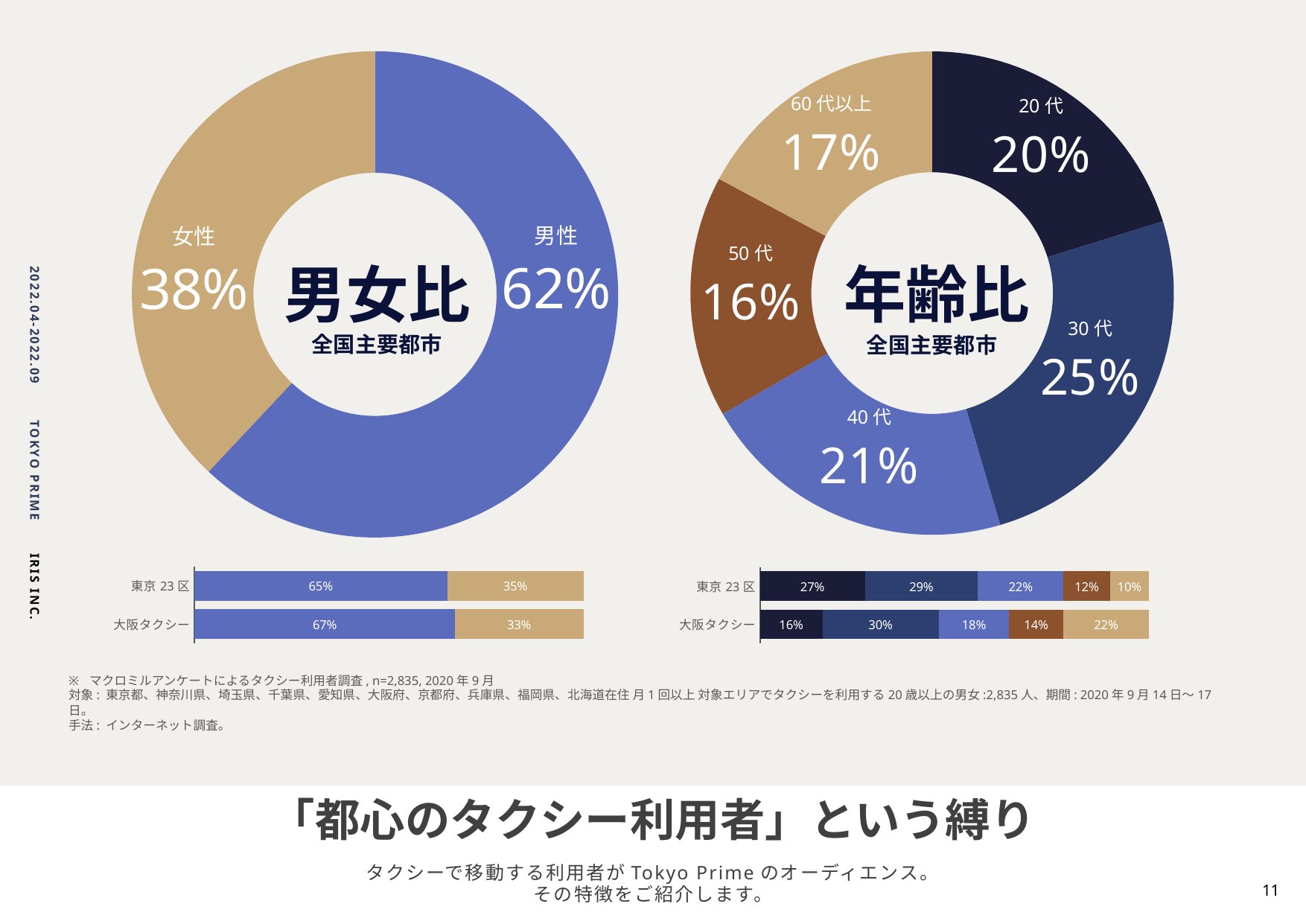
In the stacked bar chart below the 年齢比 donut, what is the value of the last (tan) segment for 大阪タクシー? 22% What kind of chart is the 男女比 chart? donut (pie) chart In the 年齢比 donut chart, which age group has the smallest share? 50代 In the 年齢比 donut chart, which age group has the largest share? 30代 In the stacked bar chart below the 男女比 donut, what is the value of the second (tan) segment for 東京 23 区? 35% In the 年齢比 donut chart, what is the share for 40代? 21% In the 年齢比 donut chart, what is the difference between the shares of 30代 and 60代以上? 8% In the stacked bar chart below the 年齢比 donut, which is larger for 東京 23 区: the first (dark navy) segment or the second (navy) segment? the second (navy) segment In the stacked bar chart below the 男女比 donut, what is the value of the first (blue) segment for 大阪タクシー? 67% In the 年齢比 donut chart, how many age groups are shown? 5 In the 男女比 donut chart, what is the share for 男性? 62% In the 男女比 donut chart, what is the share for 女性? 38%